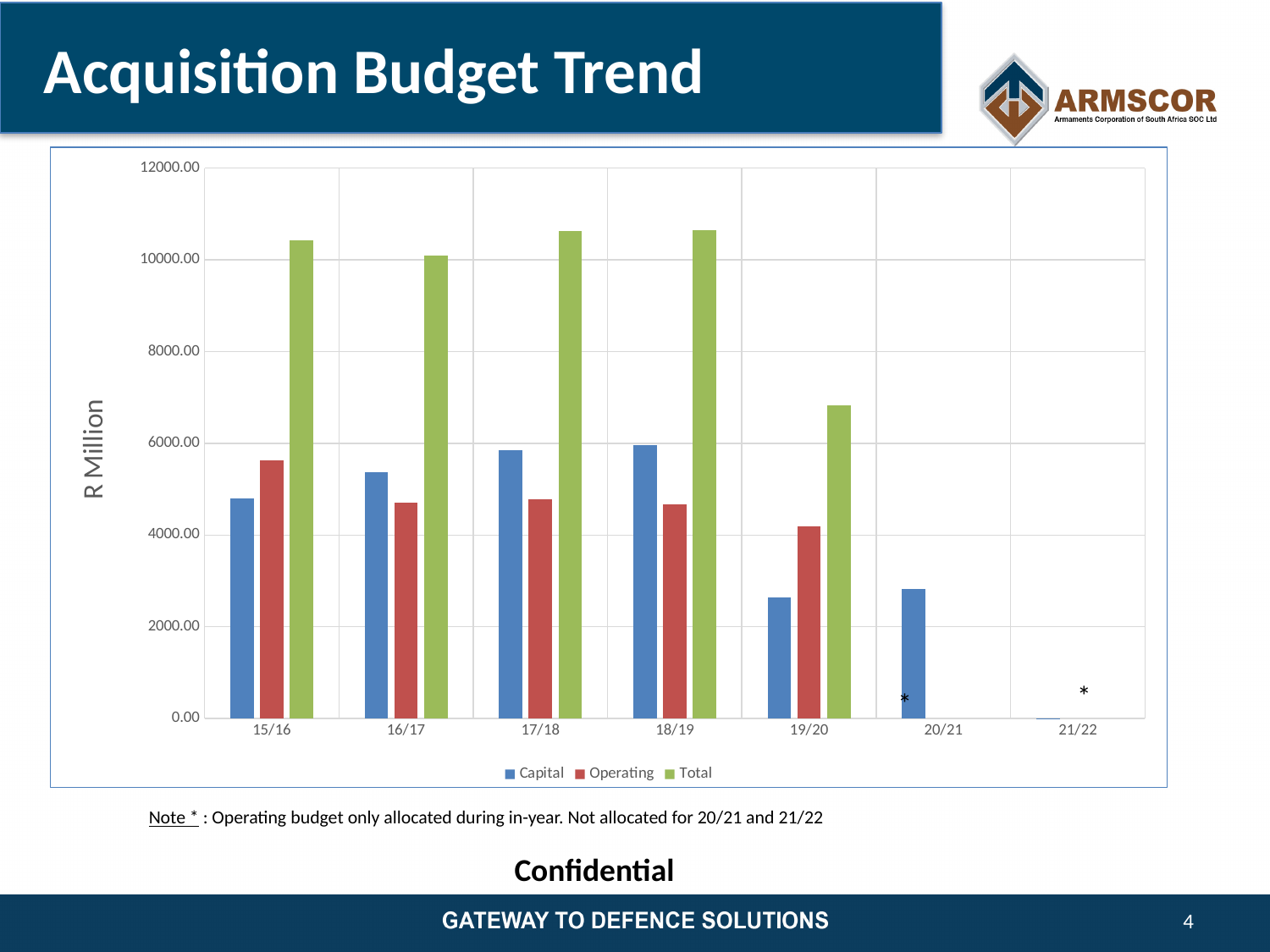
How many series does the legend list? 3 Which year has the highest Operating value? 15/16 In 16/17, which is larger, Capital or Operating? Capital In 15/16, which is larger, Capital or Operating? Operating What is the label on the vertical axis? R Million Does the Capital value rise or fall from 15/16 to 18/19? rise Among the years where a Total bar is plotted, which year has the lowest Total? 19/20 Is the Total value for 15/16 greater or less than 10000.00? greater How many financial-year categories are shown on the x axis? 7 Is the Total value for 19/20 greater or less than 8000.00? less Is the Capital value for 19/20 greater or less than 2000.00? greater What kind of chart is shown on the slide? bar chart